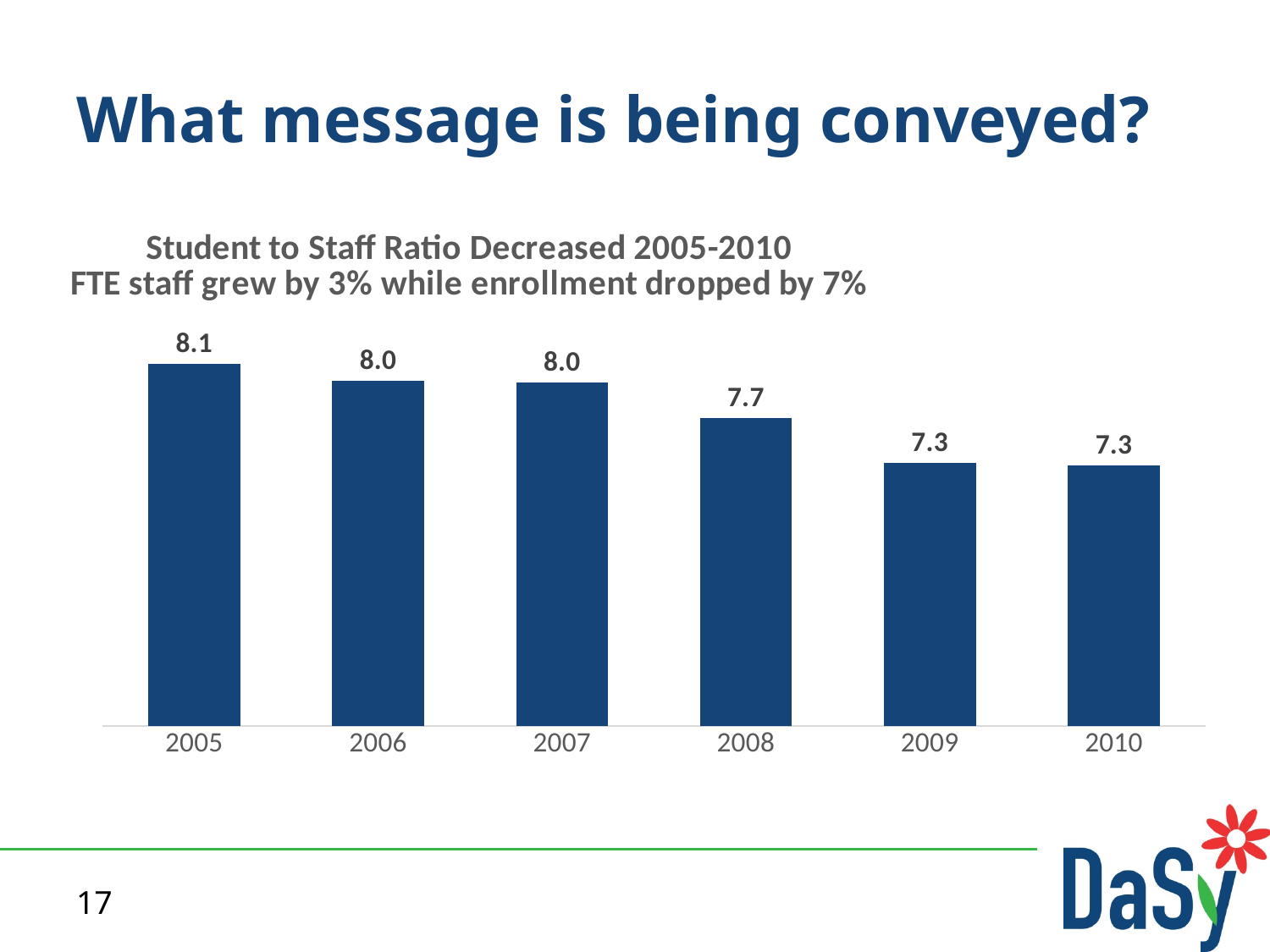
What is the student to staff ratio for 2010? 7.3 Which year has the highest student to staff ratio? 2005 What is the student to staff ratio for 2005? 8.1 What is the difference between the ratio in 2005 and the ratio in 2010? 0.8 What kind of chart is shown on the slide? Bar chart How many years are shown on the chart? 6 What is the difference between the ratio in 2007 and the ratio in 2008? 0.3 According to the chart subtitle, by what percentage did enrollment drop? 7% What is the title of the chart? Student to Staff Ratio Decreased 2005-2010 Which is larger, the ratio in 2006 or the ratio in 2009? 2006 What is the student to staff ratio for 2008? 7.7 Do the values rise or fall from 2005 to 2010? Fall